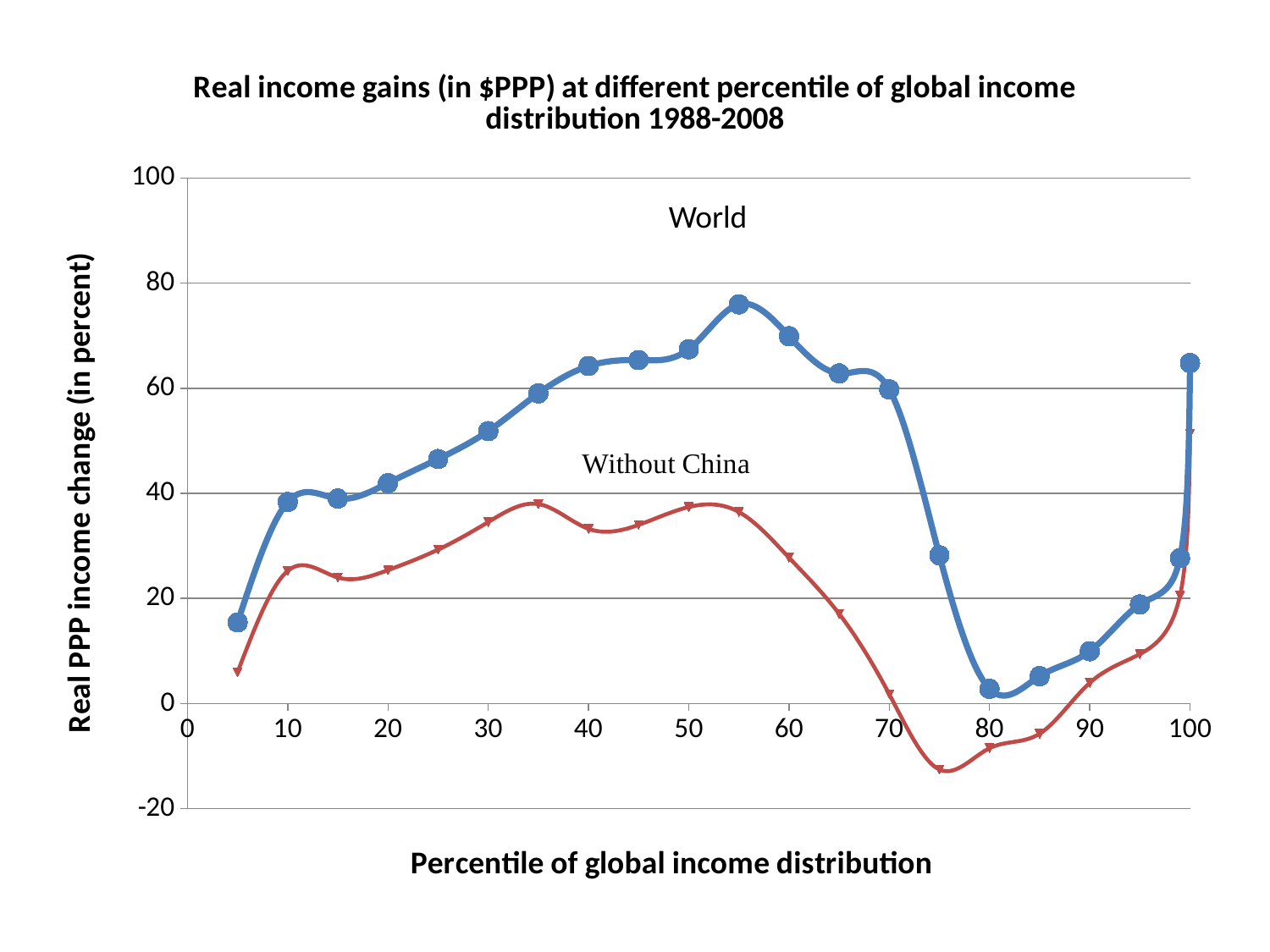
At which percentile does the World series reach its highest value? 55 What is the label of the y axis? Real PPP income change (in percent) At which percentile does the Without China series reach its lowest value? 75 At the 40th percentile, which series has the higher value, World or Without China? World Does the World series rise or fall between the 55th and 80th percentiles? fall What is the title of the chart? Real income gains (in $PPP) at different percentile of global income distribution 1988-2008 Is the World value at the 80th percentile greater or less than 20? less What kind of chart is shown on the slide? line chart At which percentile does the World series reach its lowest value? 80 Is the World value at the 55th percentile greater or less than 60? greater Is the Without China value at the 75th percentile greater or less than 0? less How many series are plotted on the chart? 2